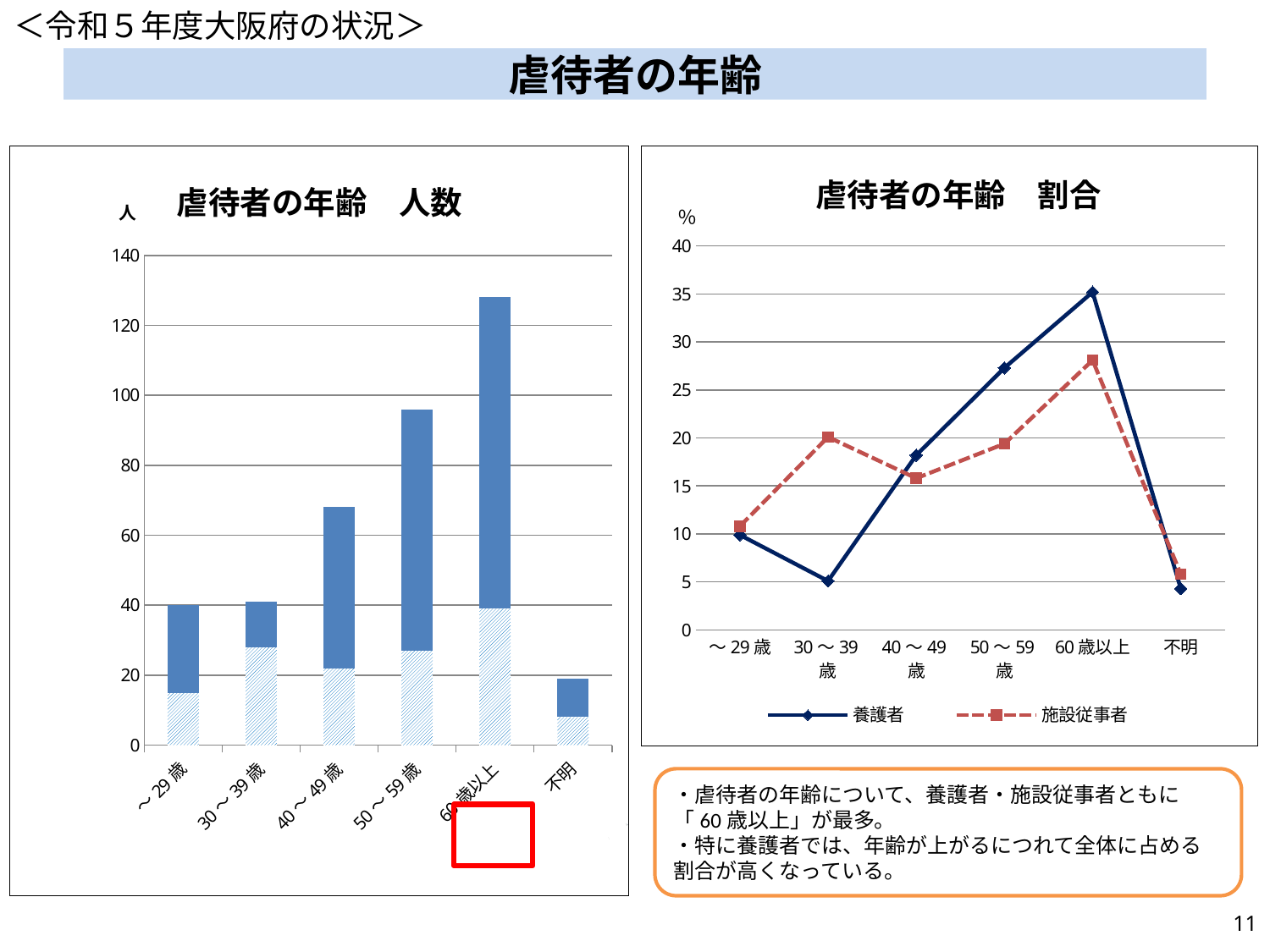
In the left chart 虐待者の年齢 人数, is the total bar for 60歳以上 greater or less than 120? greater In the right chart 虐待者の年齢 割合, at which category does the 養護者 line reach its highest value? 60歳以上 What kind of chart is the left chart titled 虐待者の年齢 人数? bar chart In the right chart 虐待者の年齢 割合, what are the two series named in the legend? 養護者 and 施設従事者 In the right chart 虐待者の年齢 割合, at 30～39歳, which series has the higher value, 養護者 or 施設従事者? 施設従事者 In the left chart 虐待者の年齢 人数, do the bar totals rise or fall from ～29歳 to 60歳以上? rise In the left chart 虐待者の年齢 人数, is the total bar for 50～59歳 greater or less than 100? less In the left chart 虐待者の年齢 人数, which category has the shortest bar? 不明 In the right chart 虐待者の年齢 割合, how many series does the legend list? 2 What kind of chart is the right chart titled 虐待者の年齢 割合? line chart In the left chart 虐待者の年齢 人数, how many age categories are shown on the x axis? 6 In the left chart 虐待者の年齢 人数, which category has the tallest bar? 60歳以上